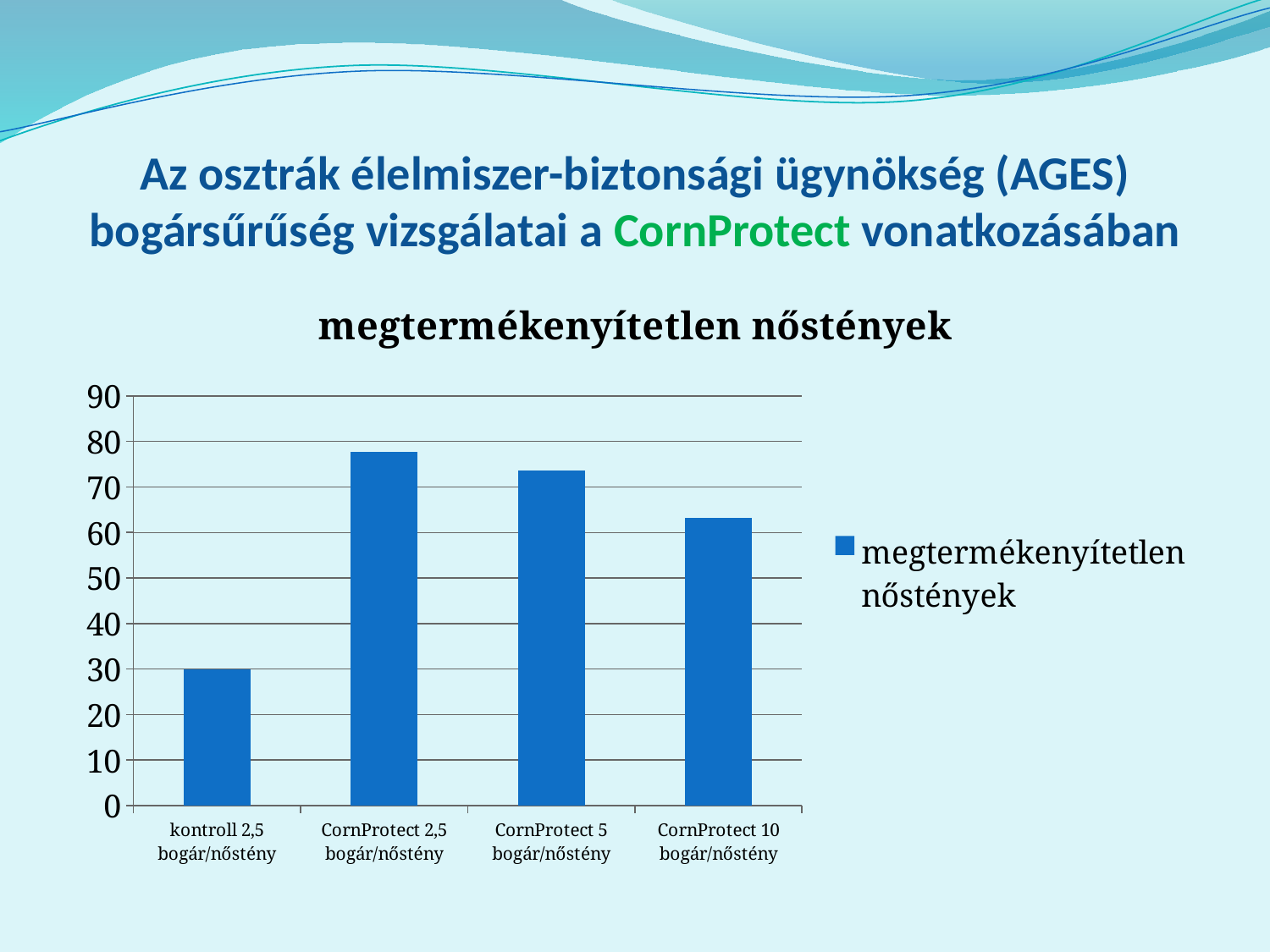
How many categories are shown on the x axis of the chart? 4 Is the value for CornProtect 2,5 bogár/nőstény greater or less than 70? greater Is the value for kontroll 2,5 bogár/nőstény greater or less than 40? less Is the value for CornProtect 5 bogár/nőstény greater or less than 80? less What kind of chart is shown on the slide? bar chart What is the title of the chart? megtermékenyítetlen nőstények How many series does the chart's legend list? 1 Do the values rise or fall from CornProtect 2,5 bogár/nőstény to CornProtect 10 bogár/nőstény? fall Which is larger, the value for CornProtect 2,5 bogár/nőstény or the value for CornProtect 10 bogár/nőstény? CornProtect 2,5 bogár/nőstény Which category has the highest value in the chart? CornProtect 2,5 bogár/nőstény Which category has the lowest value in the chart? kontroll 2,5 bogár/nőstény